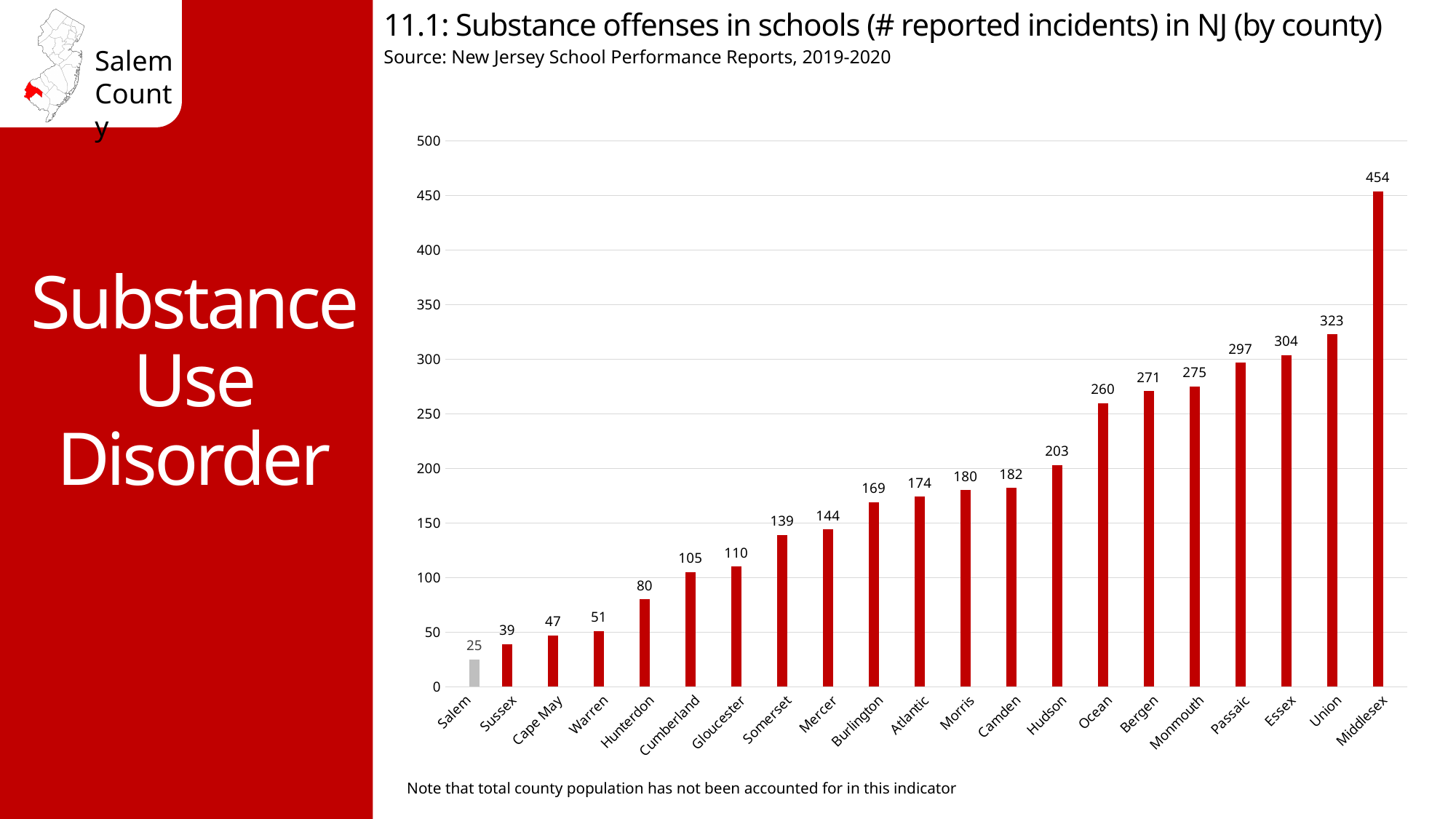
What kind of chart is shown on the slide? Bar chart Which county has the lowest number of reported incidents? Salem What is the difference between the values for Cumberland and Salem? 80 What is the value shown for Gloucester county? 110 What is the value shown for Middlesex county? 454 What is the difference between the values for Middlesex and Union? 131 Is the value for Bergen greater or less than 250? greater Which county has the highest number of reported incidents? Middlesex How many counties are shown on the chart? 21 What is the number of reported substance offense incidents in schools for Salem county? 25 Which county's bar is shown in grey rather than red? Salem Which county has a larger value, Hudson or Ocean? Ocean